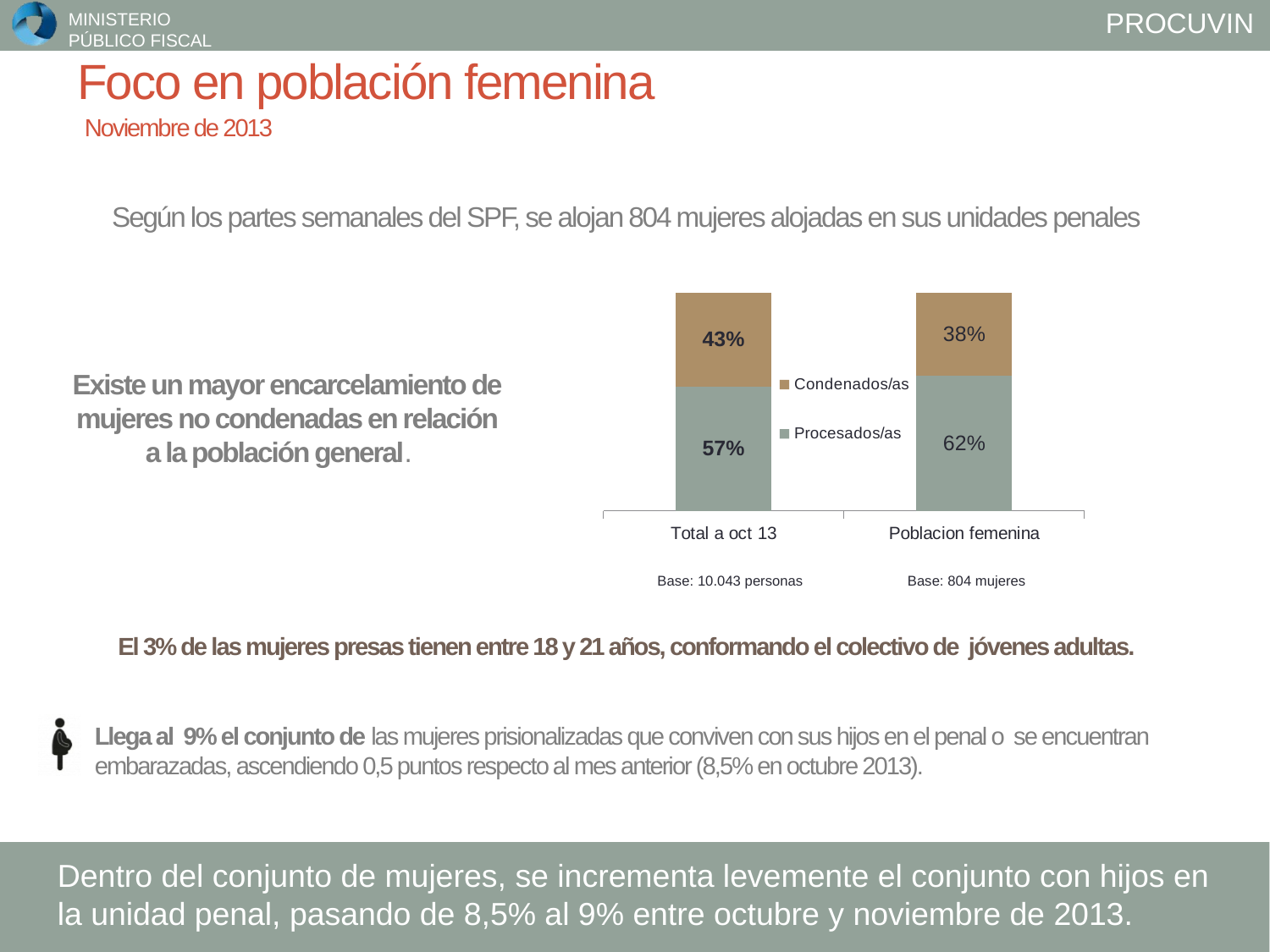
How many series does the chart legend list? 2 What is the total of the stacked bar for Poblacion femenina? 100% How many categories are shown on the x axis of the chart? 2 Which category has the higher Procesados/as value? Poblacion femenina Which category has the lower Condenados/as value? Poblacion femenina What is the Condenados/as value for Total a oct 13? 43% What is the Procesados/as value for Total a oct 13? 57% What is the Procesados/as value for Poblacion femenina? 62% What is the difference between the Procesados/as values for Poblacion femenina and Total a oct 13? 5% What is the Condenados/as value for Poblacion femenina? 38% What kind of chart is shown on the slide? Stacked bar chart Is the Condenados/as value larger for Total a oct 13 or for Poblacion femenina? Total a oct 13